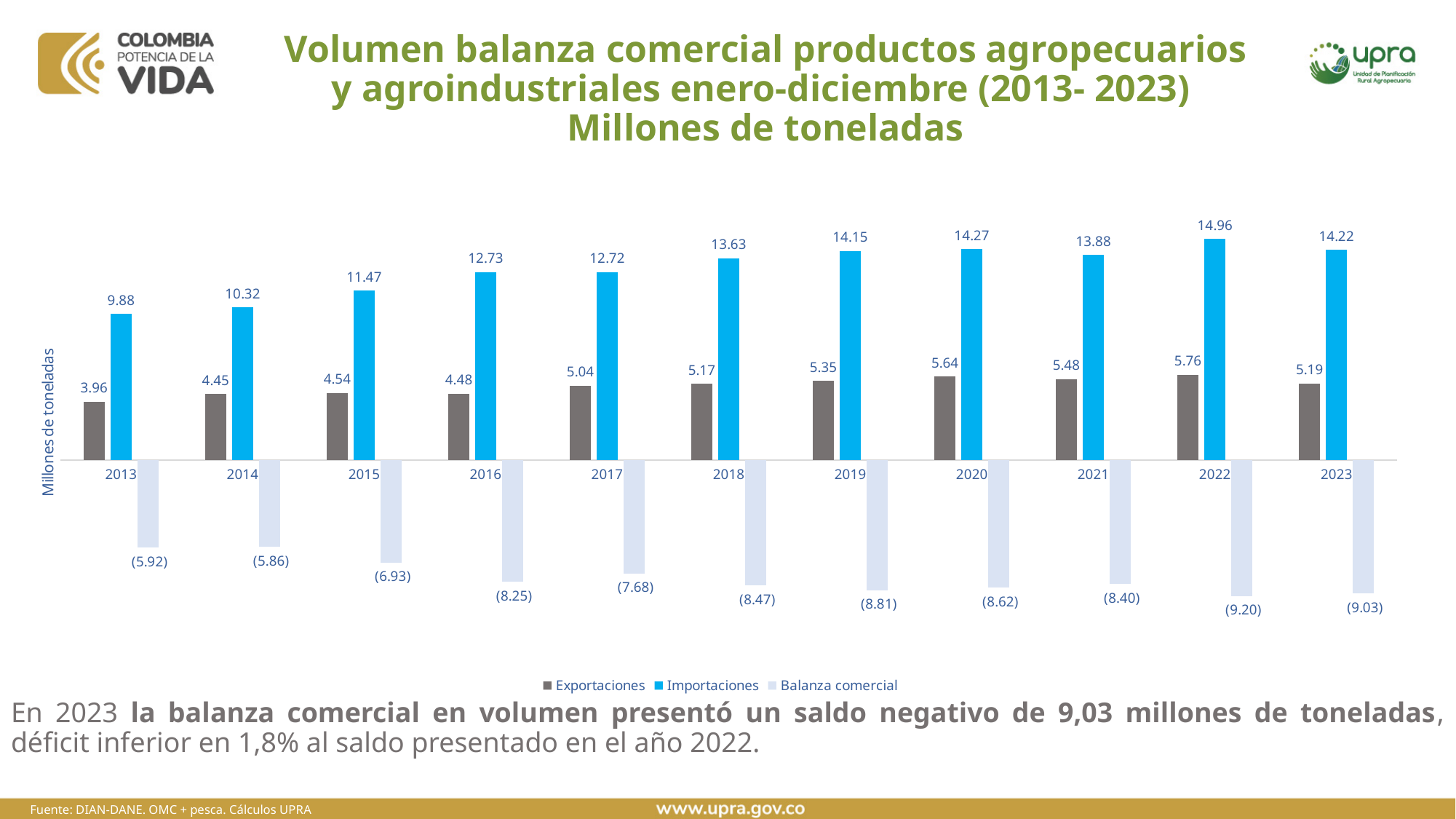
How many series does the legend list? 3 What colour are the Importaciones bars? Blue In which year are Exportaciones lowest? 2013 What kind of chart is shown on the slide? Bar chart How many years are shown on the x axis? 11 Which is larger, Exportaciones in 2022 or Exportaciones in 2023? Exportaciones in 2022 What is the difference between Importaciones and Exportaciones in 2020? 8.63 In which year are Importaciones highest? 2022 What is the value of Importaciones in 2023? 14.22 What is the Balanza comercial value shown for 2022? (9.20) What is the value of Exportaciones in 2013? 3.96 Do Importaciones generally rise or fall from 2013 to 2022? Rise